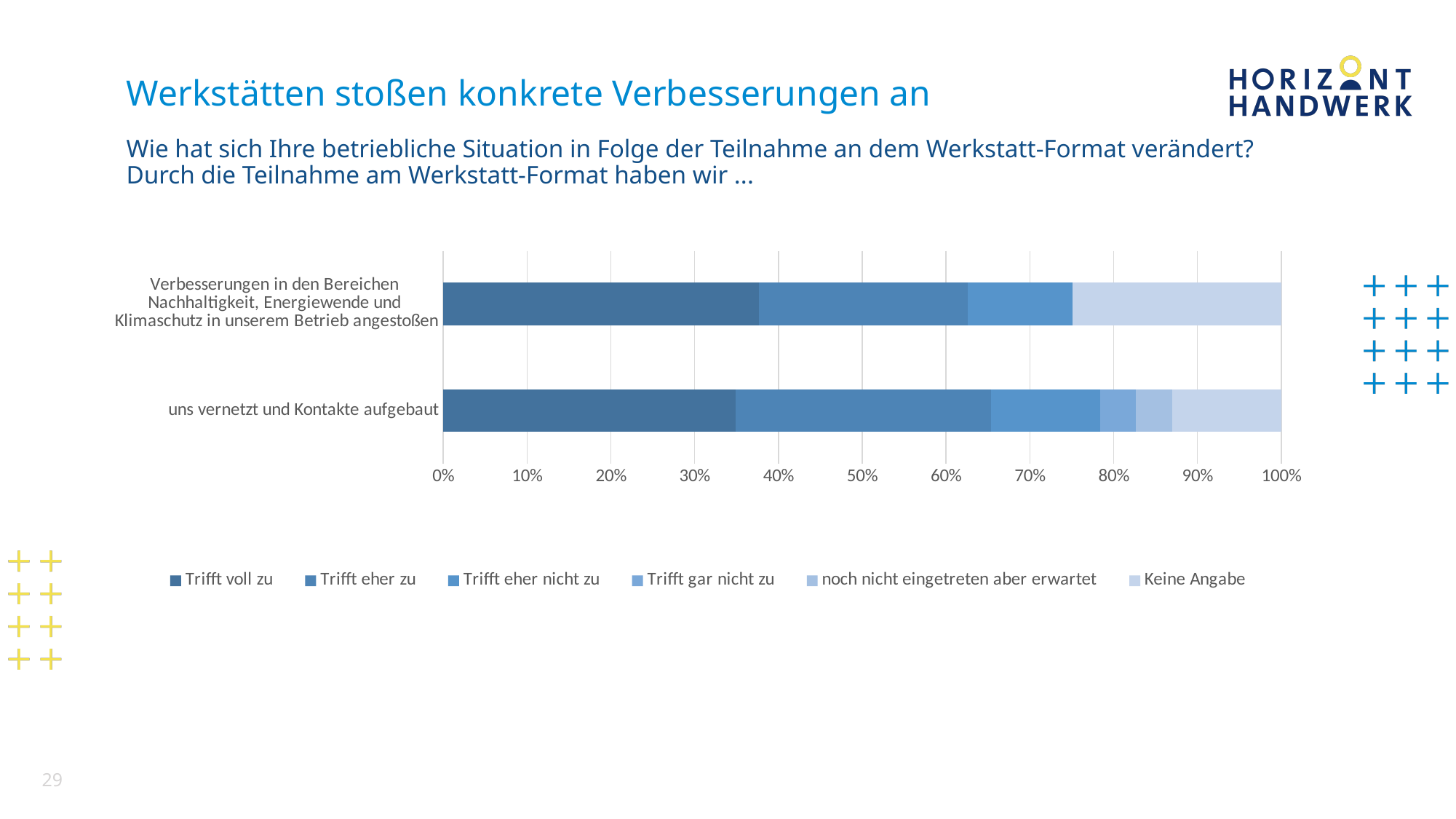
How many coloured segments make up the bar for 'uns vernetzt und Kontakte aufgebaut'? 6 Is the 'Trifft voll zu' share for 'Verbesserungen in den Bereichen Nachhaltigkeit, Energiewende und Klimaschutz in unserem Betrieb angestoßen' greater or less than 30%? greater What kind of chart is shown on the slide? bar chart Is the 'Trifft voll zu' share for 'uns vernetzt und Kontakte aufgebaut' greater or less than 30%? greater What is the last entry in the chart legend? Keine Angabe What is the first entry in the chart legend? Trifft voll zu How many coloured segments make up the bar for 'Verbesserungen in den Bereichen Nachhaltigkeit, Energiewende und Klimaschutz in unserem Betrieb angestoßen'? 4 Is the 'Trifft voll zu' share for 'uns vernetzt und Kontakte aufgebaut' greater or less than 40%? less How many categories (bars) does the chart show? 2 How many series does the legend list? 6